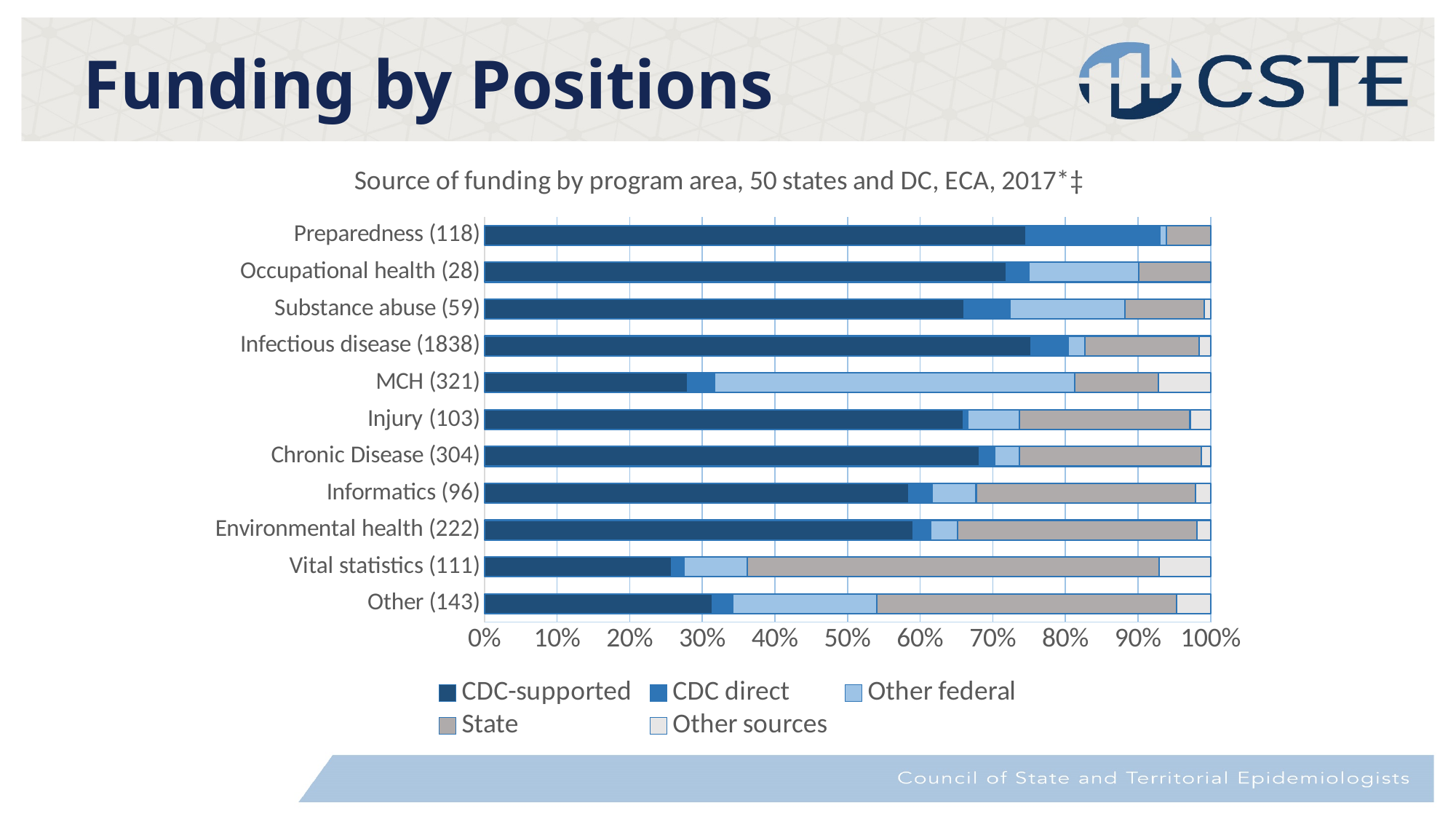
Is the CDC-supported share for Preparedness (118) greater or less than 70%? greater How many program areas (categories) are plotted on the chart? 11 Is the CDC-supported share for MCH (321) greater or less than 30%? less What kind of chart is shown on the slide? Stacked bar chart Which has the larger State share: Vital statistics (111) or Preparedness (118)? Vital statistics (111) Is the CDC-supported share for Infectious disease (1838) greater or less than 70%? greater Which legend entry is shown in the darkest blue colour? CDC-supported Which has the larger CDC-supported share: Preparedness (118) or MCH (321)? Preparedness (118) What is the title of the chart? Source of funding by program area, 50 states and DC, ECA, 2017*‡ How many funding sources (series) does the legend list? 5